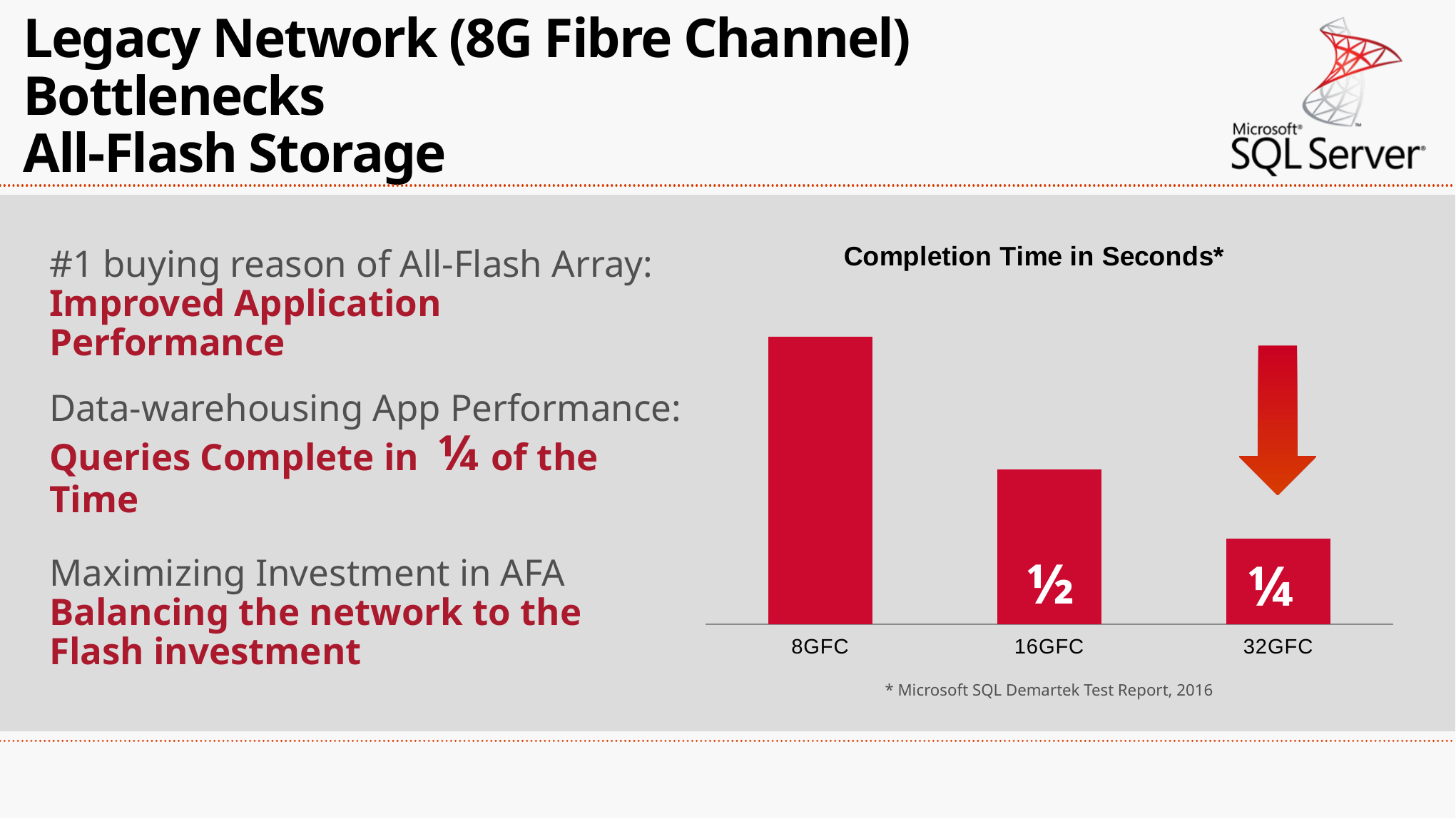
What label is printed on the 32GFC bar? ¼ Which has the larger completion time, 16GFC or 32GFC? 16GFC What source is cited below the chart? Microsoft SQL Demartek Test Report, 2016 What label is printed on the 16GFC bar? ½ Which has the larger completion time, 8GFC or 16GFC? 8GFC How many bars (categories) does the chart show? 3 Which category has the lowest completion time? 32GFC Do the completion times rise or fall from 8GFC to 32GFC? fall What is the title of the chart? Completion Time in Seconds* What kind of chart is shown on the slide? bar chart Which category has the highest completion time? 8GFC